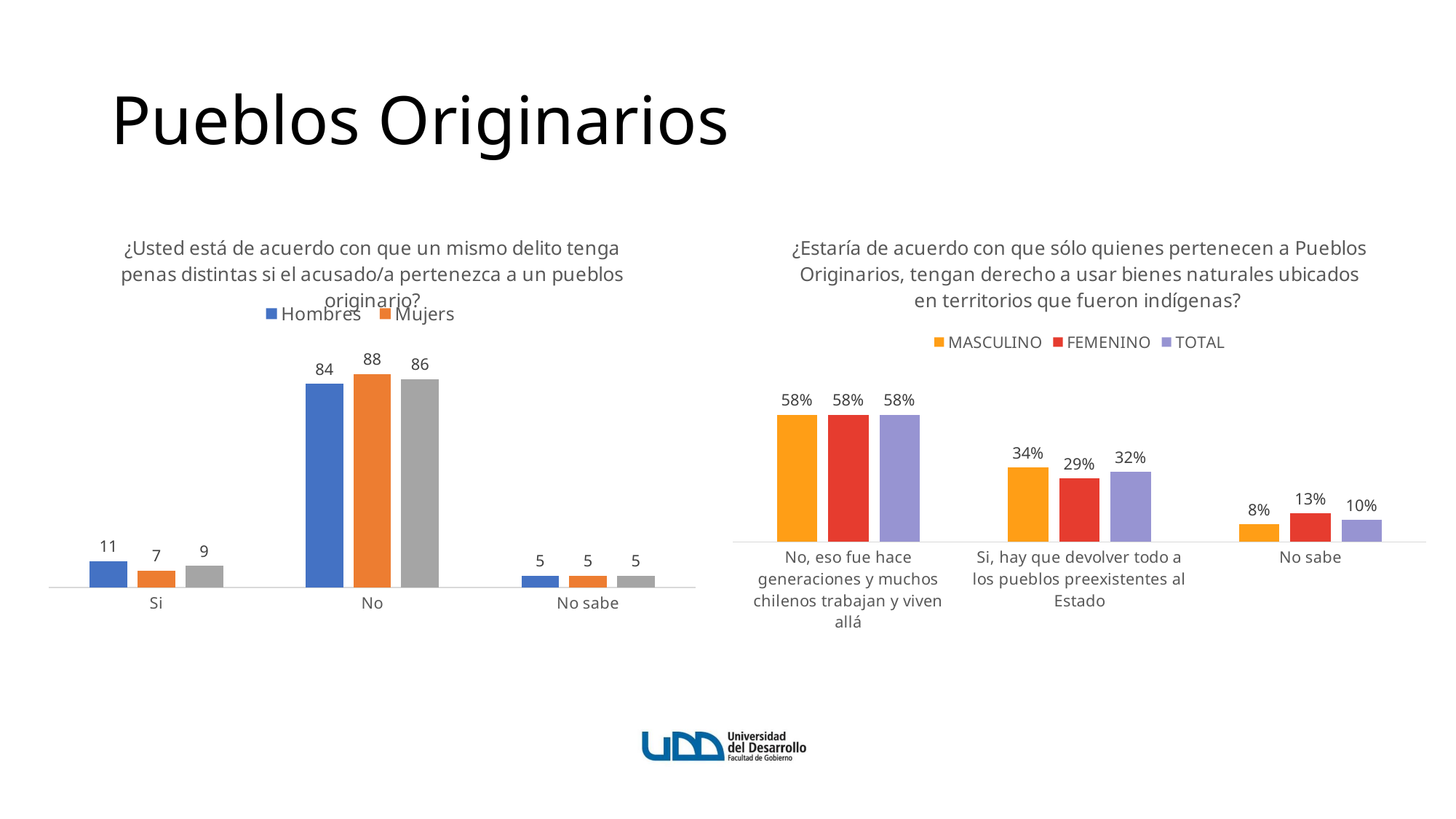
In the left chart, what is the value for Hombres in the 'No' category? 84 In the left chart, what is the difference between the Mujers and Hombres values in the 'No' category? 4 In the right chart, what is the difference between the MASCULINO and FEMENINO values for 'Si, hay que devolver todo a los pueblos preexistentes al Estado'? 5% In the left chart, how many categories are shown on the x axis? 3 In the left chart, which category has the highest value for Hombres? No In the right chart, how many series does the legend list? 3 In the right chart, what is the MASCULINO value for 'Si, hay que devolver todo a los pueblos preexistentes al Estado'? 34% In the left chart, what is the value for Mujers in the 'Si' category? 7 In the right chart, what is the FEMENINO value for 'No sabe'? 13% In the left chart, which is larger in the 'Si' category: Hombres or Mujers? Hombres What type of chart is the right chart? Bar chart In the right chart, what is the TOTAL value for 'No, eso fue hace generaciones y muchos chilenos trabajan y viven allá'? 58%